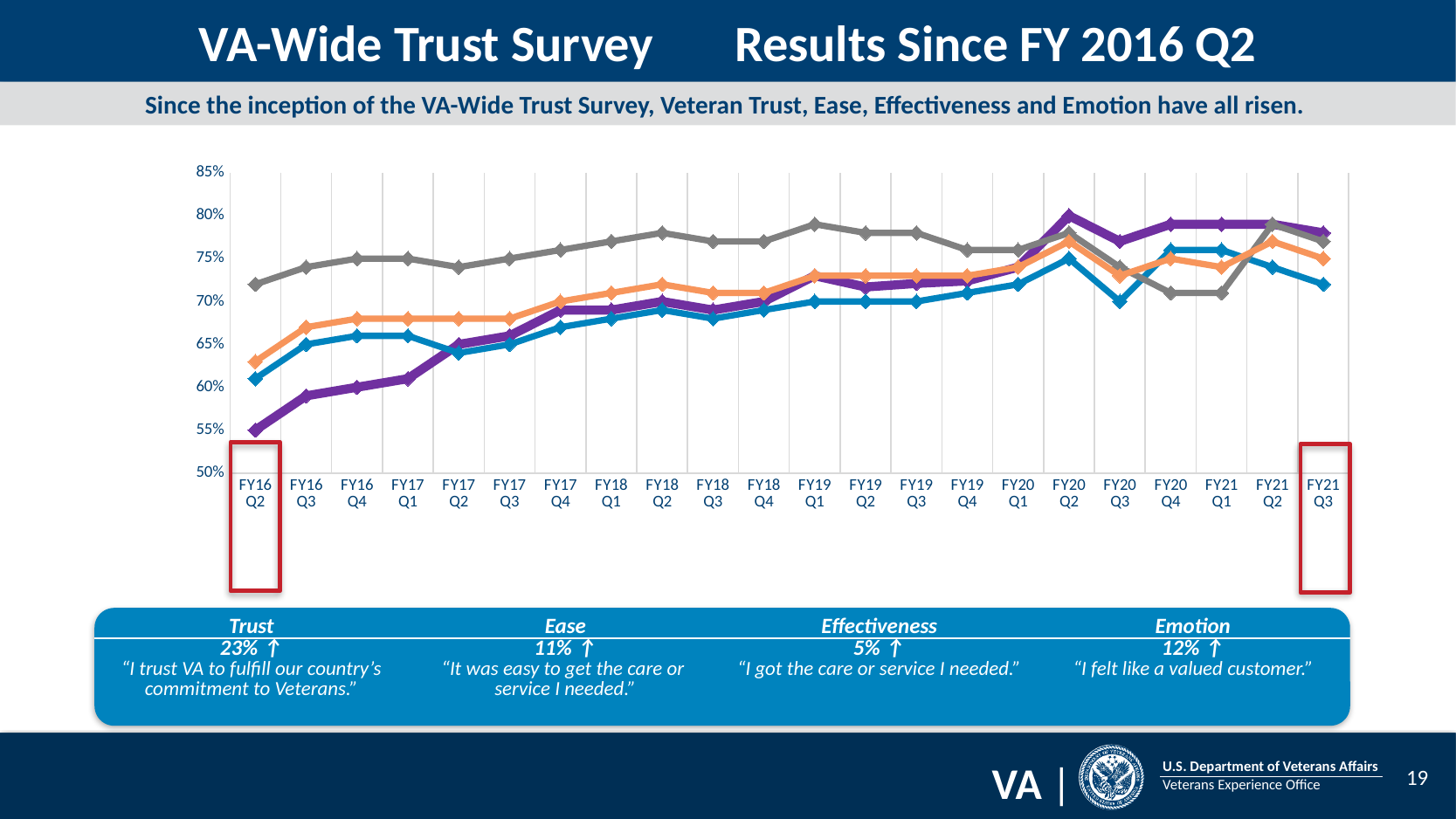
What kind of chart is shown on the slide? line chart Is the gray line's value at FY19 Q1 greater or less than 75%? greater How many quarters are shown along the x axis of the chart? 22 What is the last quarter shown on the x axis? FY21 Q3 Is the purple line's value at FY16 Q2 greater or less than 60%? less Does the purple line generally rise or fall from FY16 Q2 to FY21 Q3? rise Is the blue line's value at FY16 Q2 greater or less than 65%? less Which line has the highest value at FY16 Q2? the gray line Which line has the lowest value at FY16 Q2? the purple line How many lines are plotted on the chart? 4 What is the first quarter shown on the x axis? FY16 Q2